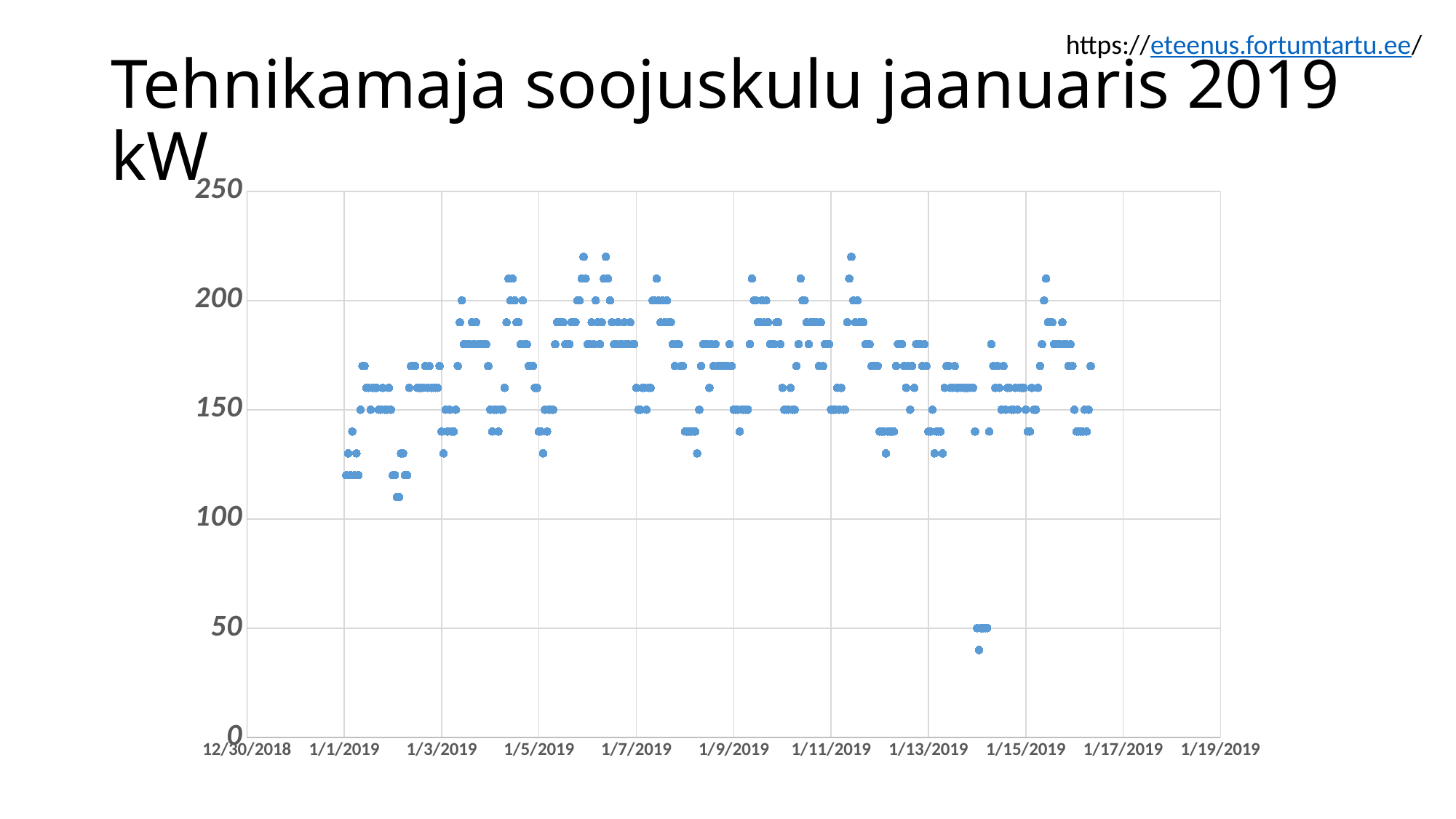
What is the title of the slide above the chart? Tehnikamaja soojuskulu jaanuaris 2019 Is the highest plotted value on the chart greater or less than 250? less How many date labels are shown on the x axis? 11 What unit is indicated for the values on the chart? kW Is the cluster of points near the bottom of the chart around 1/14/2019 greater or less than 100? less What is the highest value shown on the y axis? 250 What kind of chart is shown on the slide? scatter chart Is the lowest plotted value on the chart greater or less than 50? less Are there any plotted points after 1/17/2019? No What is the last date label on the x axis? 1/19/2019 What is the first date label on the x axis? 12/30/2018